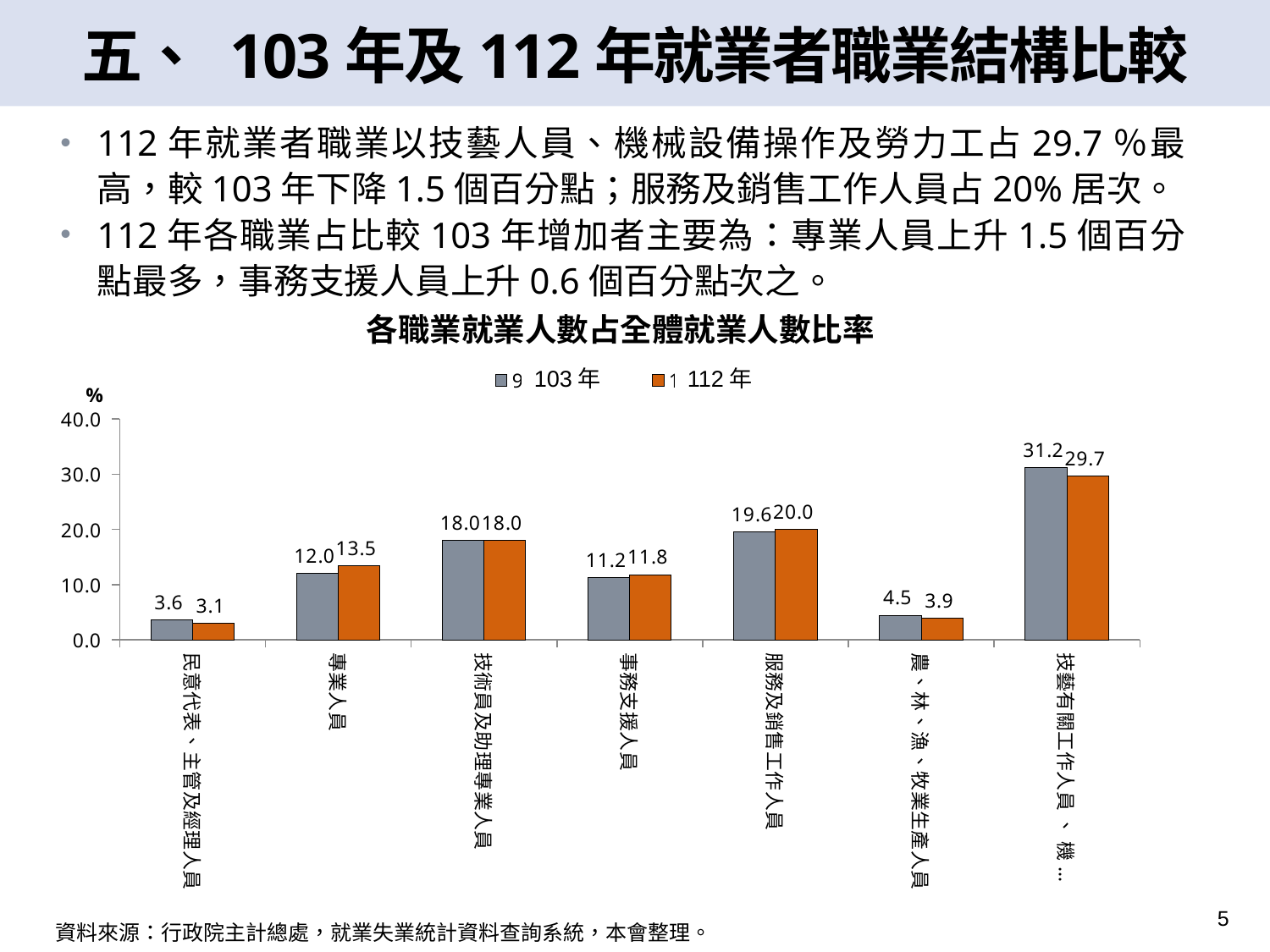
What is the value for 專業人員 in the 112 年 series? 13.5 What is the value for 農、林、漁、牧業生產人員 in the 112 年 series? 3.9 Which category has the lowest value in the 103 年 series? 民意代表、主管及經理人員 What kind of chart is shown on the slide? bar chart For 事務支援人員, which is larger: the 103 年 value or the 112 年 value? 112 年 What is the difference between the 103 年 and 112 年 values for 技藝有關工作人員、機…? 1.5 Is the 112 年 value for 技藝有關工作人員、機… greater or less than 20.0? greater How many occupation categories are shown on the x axis? 7 How many series does the legend list? 2 What is the difference between the 103 年 and 112 年 values for 專業人員? 1.5 What is the value for 服務及銷售工作人員 in the 103 年 series? 19.6 Which category has the highest value in the 112 年 series? 技藝有關工作人員、機…